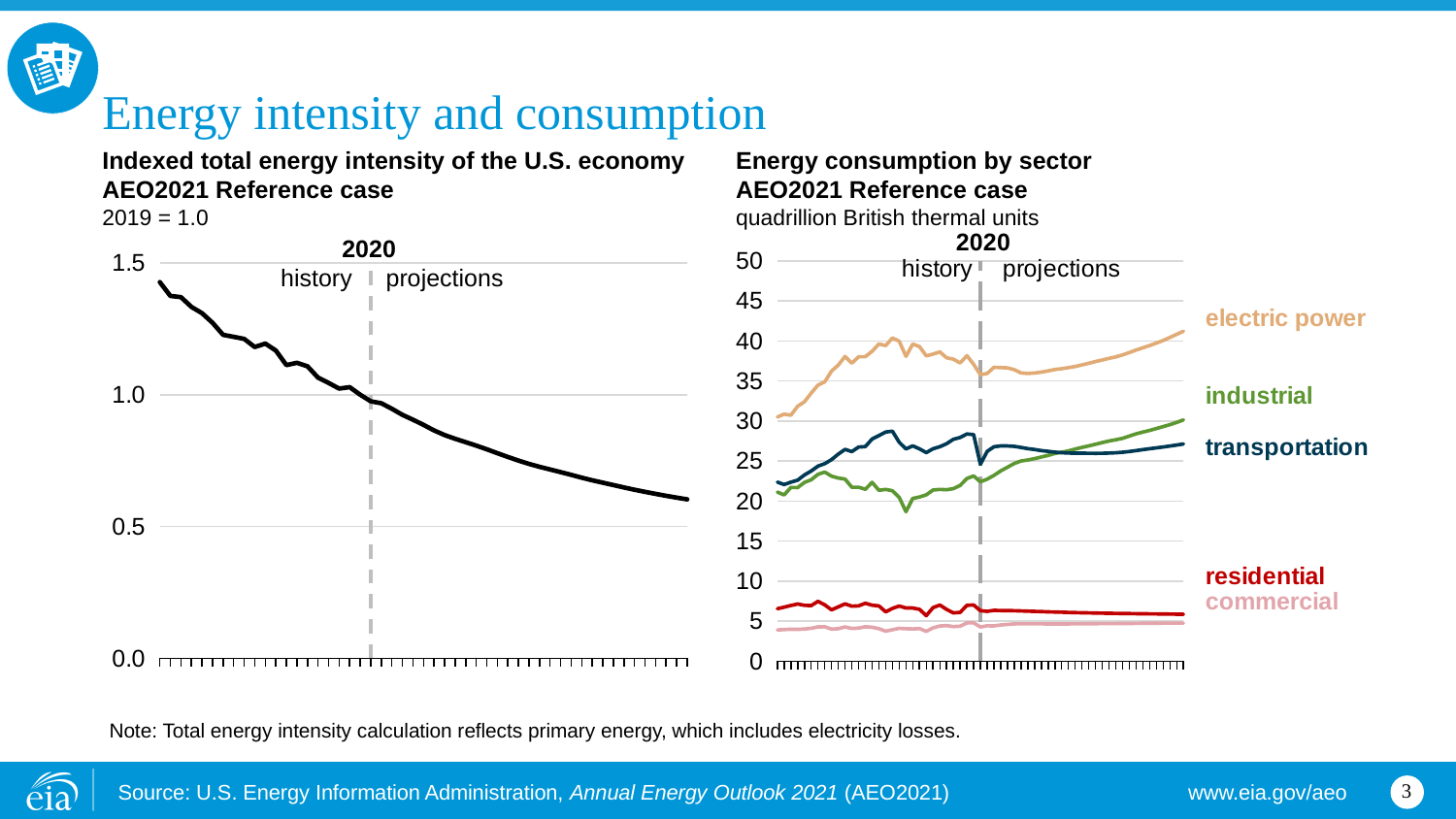
What kind of chart is the 'Indexed total energy intensity of the U.S. economy' chart on the left? line chart In the 'Energy consumption by sector' chart, is the electric power value at the end of the projection period greater or less than 35? greater How many sector series are plotted in the 'Energy consumption by sector' chart? 5 In the 'Indexed total energy intensity of the U.S. economy' chart, what is the index value for 2019? 1.0 In the 'Energy consumption by sector' chart, is the residential value at the end of the projection period greater or less than 10? less In the 'Indexed total energy intensity of the U.S. economy' chart, is the value at the end of the projection period greater or less than 1.0? less In the 'Indexed total energy intensity of the U.S. economy' chart, does the line rise or fall over time? fall What unit is used on the 'Energy consumption by sector' chart? quadrillion British thermal units In the 'Energy consumption by sector' chart, which sector has the highest energy consumption? electric power What kind of chart is the 'Energy consumption by sector' chart on the right? line chart In the 'Energy consumption by sector' chart, which sector has the lowest energy consumption? commercial In the 'Energy consumption by sector' chart, which sector has higher consumption at the end of the projection period, industrial or transportation? industrial